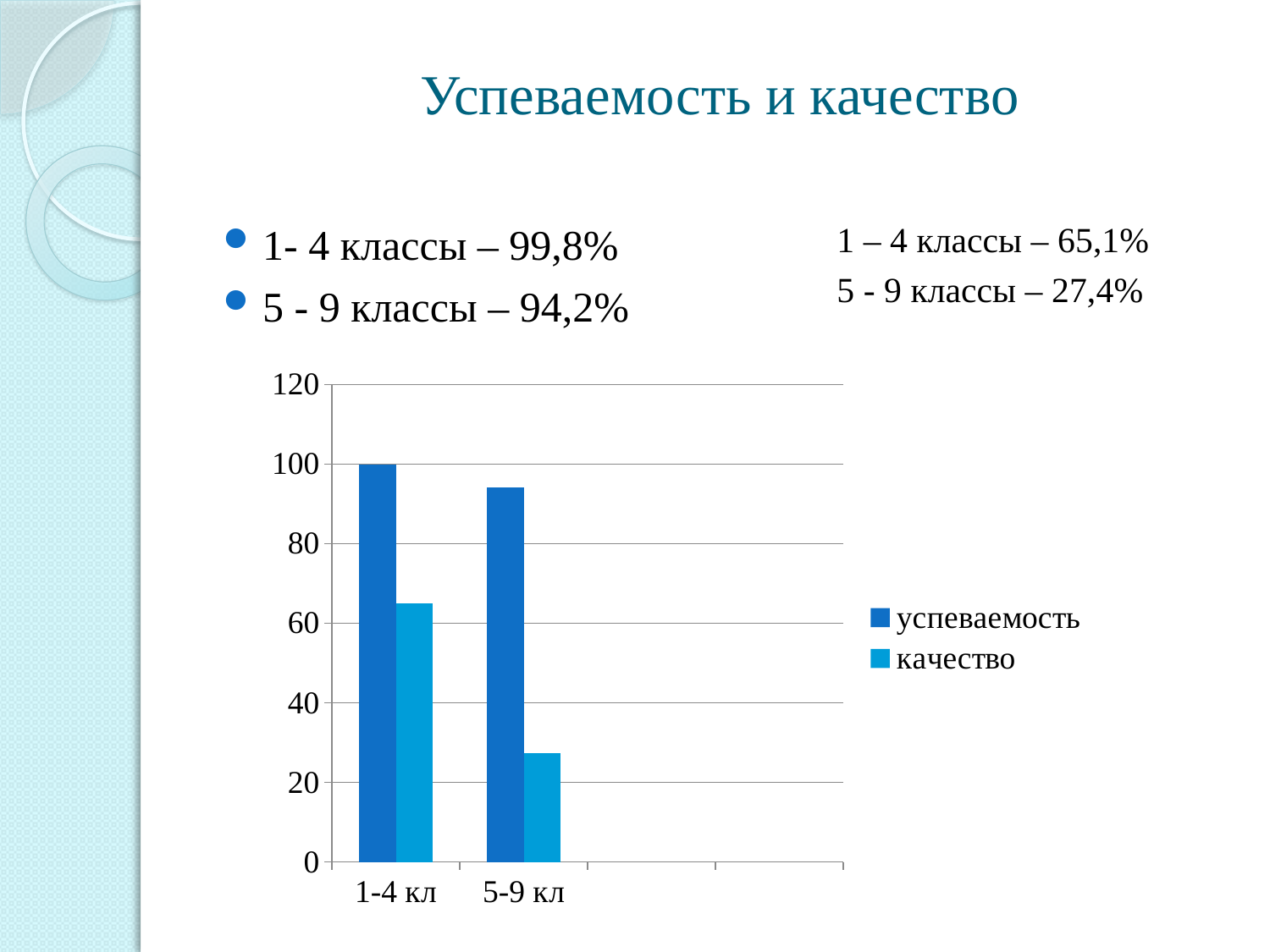
Is the качество value for 1-4 кл greater or less than 60? greater According to the slide, what is the успеваемость for 1-4 классы? 99,8% According to the slide, what is the качество for 5-9 классы? 27,4% How many series does the chart legend list? 2 Does the качество value rise or fall from 1-4 кл to 5-9 кл? fall Is the качество value for 5-9 кл greater or less than 40? less Is the успеваемость value for 5-9 кл greater or less than 80? greater How many categories have bars plotted in the chart? 2 What kind of chart is shown on the slide? bar chart Which category has the higher успеваемость bar, 1-4 кл or 5-9 кл? 1-4 кл What are the two series named in the chart legend? успеваемость, качество Which category has the lowest качество bar? 5-9 кл